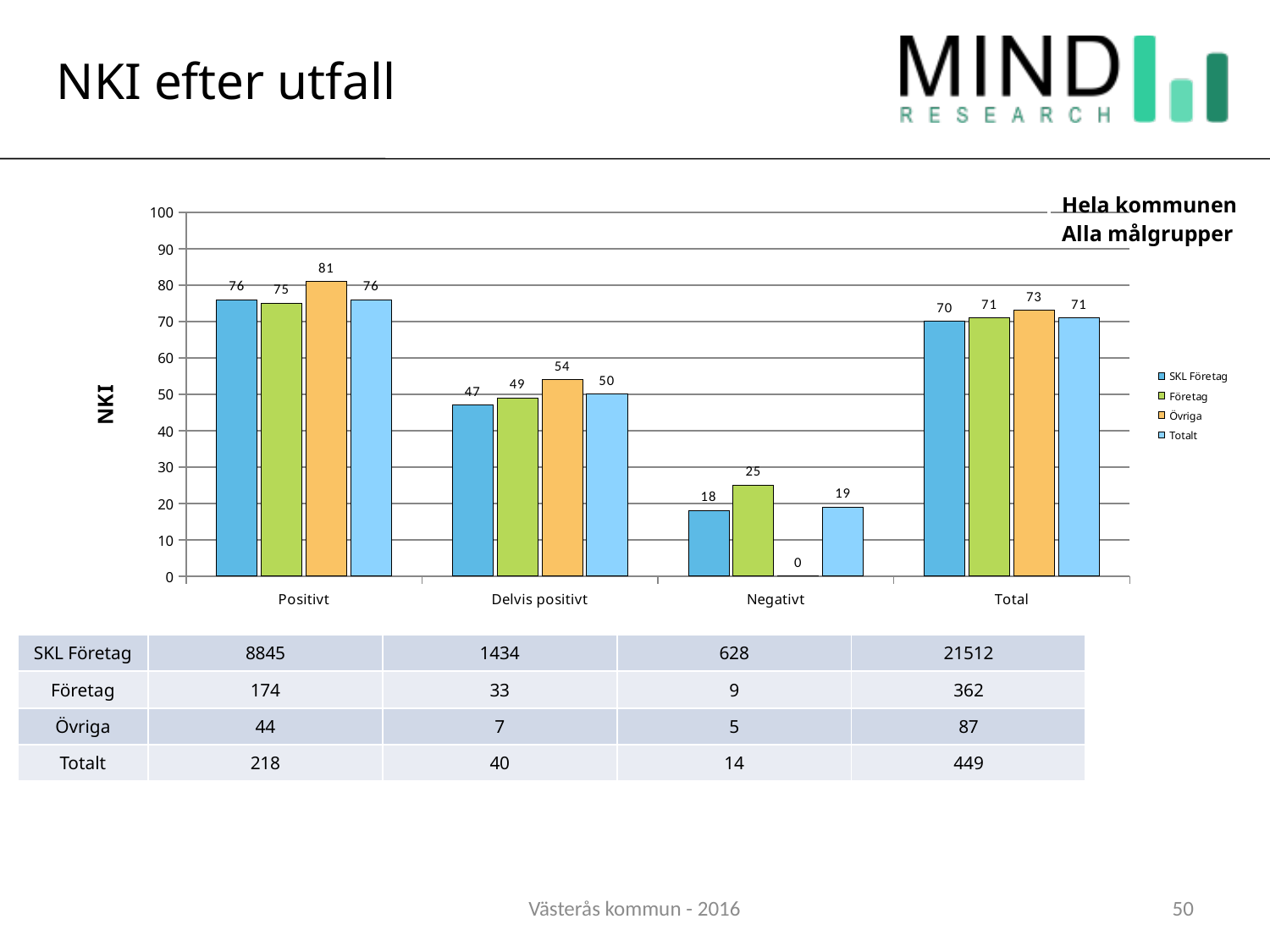
Which is larger: the Företag value for Total or the SKL Företag value for Total? Företag What kind of chart is shown on the slide? Bar chart What is the NKI value for SKL Företag in the Delvis positivt category? 47 Which series has the lowest NKI value in the Negativt category? Övriga What is the NKI value for Företag in the Negativt category? 25 How many series does the legend list? 4 How many categories are shown on the x axis? 4 Which series has the highest NKI value in the Positivt category? Övriga What is the NKI value for Övriga in the Positivt category? 81 What is the label of the y axis? NKI What is the NKI value for Totalt in the Total category? 71 What is the difference between the Övriga and SKL Företag values in the Delvis positivt category? 7